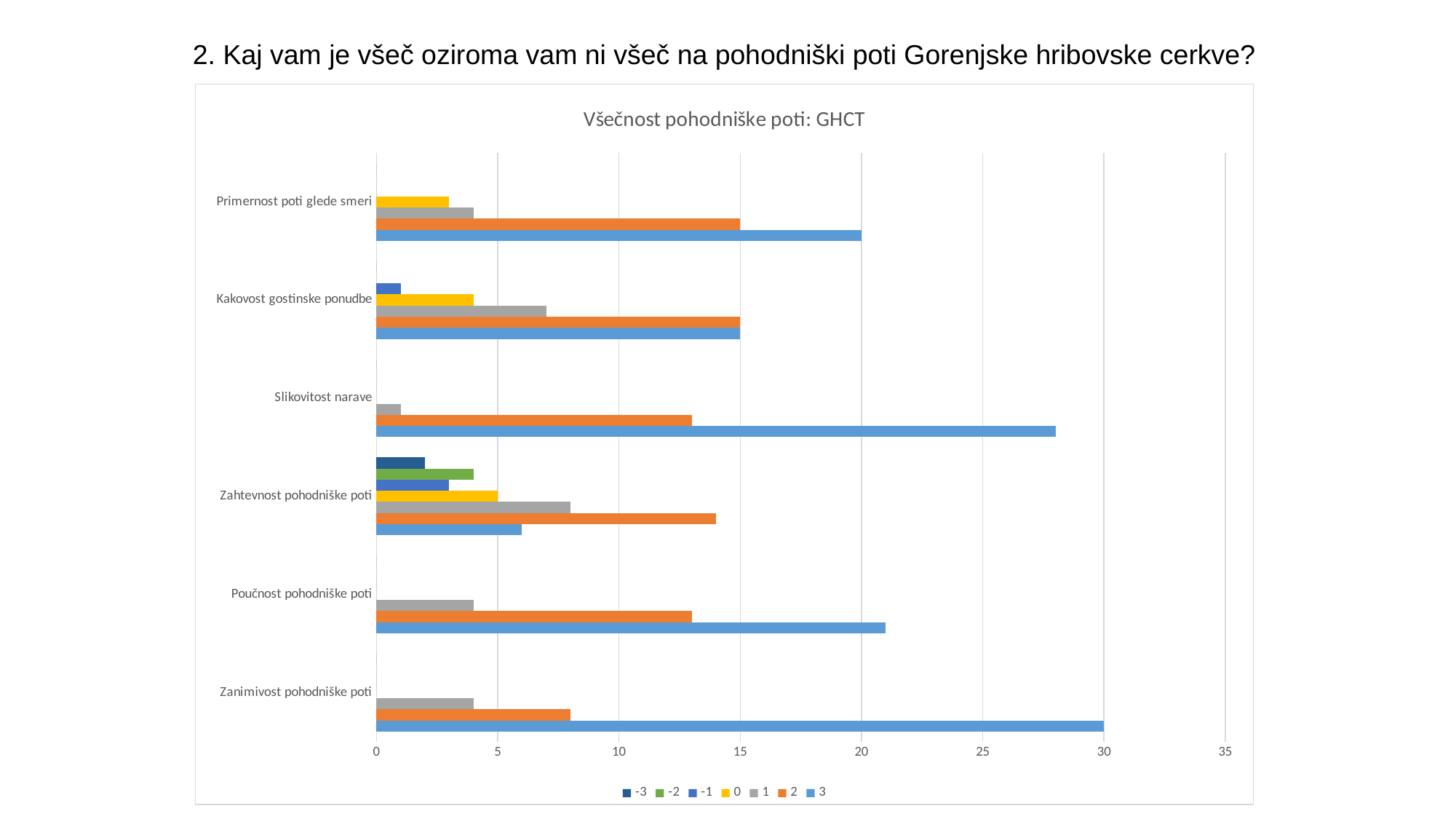
What type of chart is shown on the slide? bar chart What is the value of series "3" for Primernost poti glede smeri? 20 What is the title of the chart? Všečnost pohodniške poti: GHCT Is the value of series "3" for Slikovitost narave greater or less than 25? greater How many categories are shown on the vertical axis? 6 How many series does the legend list? 7 Which category has the highest value for series "3"? Zanimivost pohodniške poti Is the value of series "2" for Zanimivost pohodniške poti greater or less than 10? less Which category has the larger value for series "2": Zahtevnost pohodniške poti or Zanimivost pohodniške poti? Zahtevnost pohodniške poti What is the value of series "2" for Primernost poti glede smeri? 15 Which category has the lowest value for series "3"? Zahtevnost pohodniške poti What is the value of series "3" for Zanimivost pohodniške poti? 30